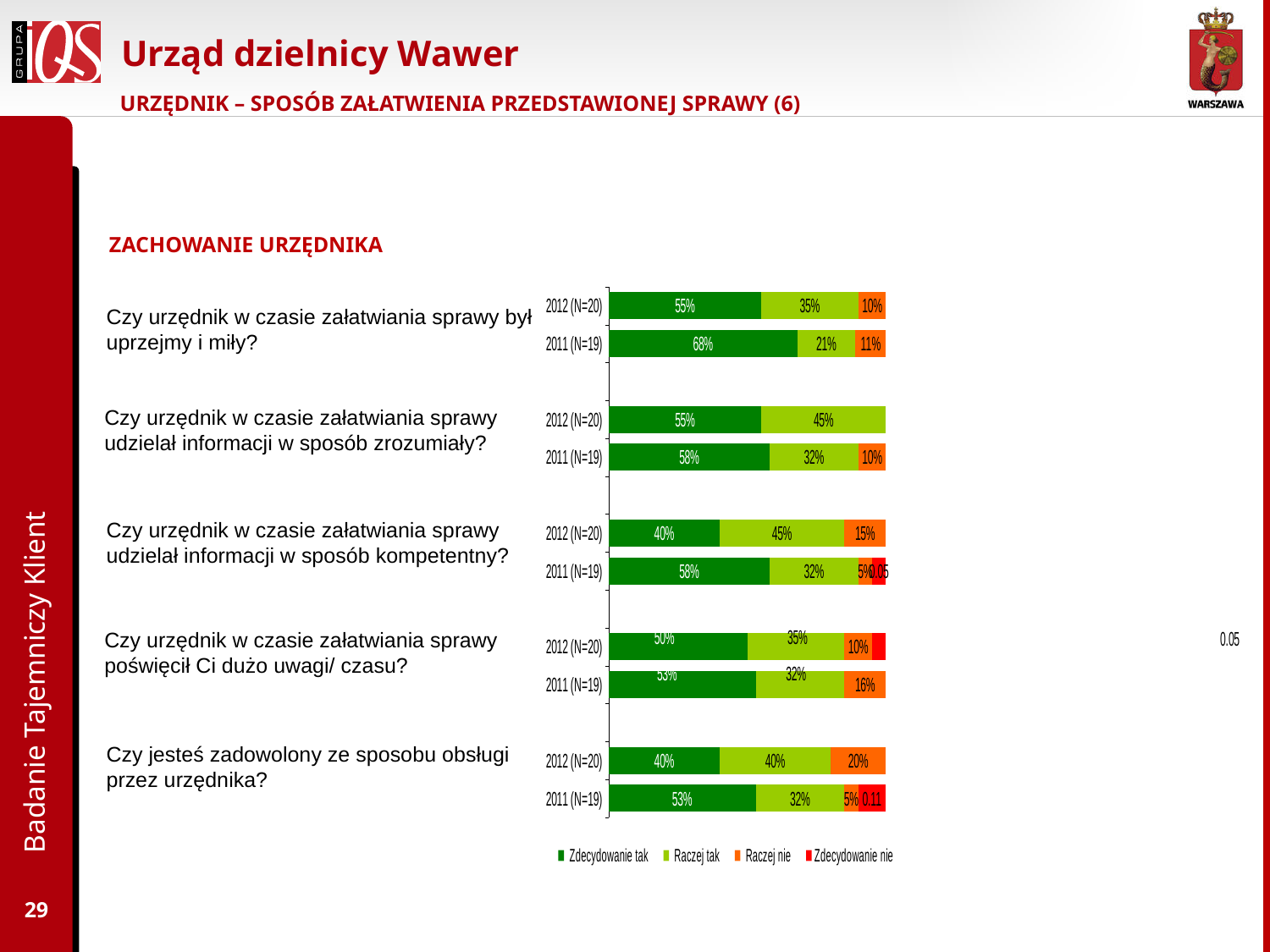
For the question 'Czy jesteś zadowolony ze sposobu obsługi przez urzędnika?', what is the 'Raczej nie' value for 2012 (N=20)? 20% For the question 'Czy urzędnik w czasie załatwiania sprawy był uprzejmy i miły?', what is the difference between the 'Zdecydowanie tak' values for 2011 (N=19) and 2012 (N=20)? 13% For the question 'Czy urzędnik w czasie załatwiania sprawy był uprzejmy i miły?', what is the 'Zdecydowanie tak' value for 2011 (N=19)? 68% For the question 'Czy urzędnik w czasie załatwiania sprawy poświęcił Ci dużo uwagi/ czasu?', what is the 'Raczej nie' value for 2011 (N=19)? 16% For the question 'Czy jesteś zadowolony ze sposobu obsługi przez urzędnika?', which year has the larger 'Zdecydowanie tak' value, 2012 (N=20) or 2011 (N=19)? 2011 (N=19) For the question 'Czy urzędnik w czasie załatwiania sprawy był uprzejmy i miły?', what is the 'Raczej tak' value for 2012 (N=20)? 35% For the question 'Czy urzędnik w czasie załatwiania sprawy udzielał informacji w sposób kompetentny?', what is the 'Raczej nie' value for 2012 (N=20)? 15% What are the four legend entries of the chart? Zdecydowanie tak, Raczej tak, Raczej nie, Zdecydowanie nie What kind of chart is shown on the slide? stacked bar chart For the question 'Czy urzędnik w czasie załatwiania sprawy udzielał informacji w sposób zrozumiały?', what is the 'Raczej tak' value for 2012 (N=20)? 45% How many series does the chart legend list? 4 How many bars are plotted in the chart in total? 10